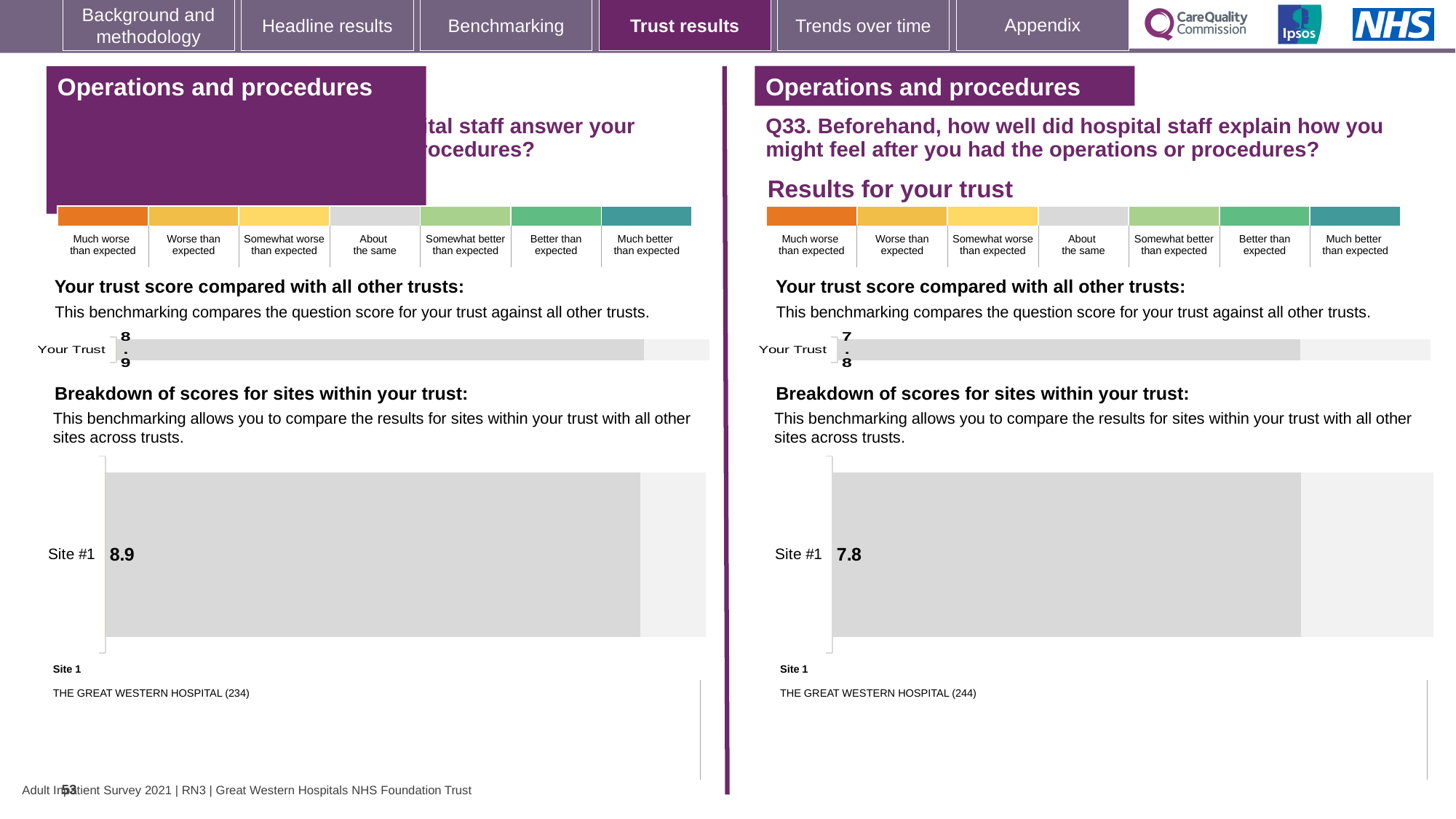
On the right panel (Q33), what is the score shown for Your Trust in the 'Your trust score compared with all other trusts' chart? 7.8 How many sites are shown in the 'Breakdown of scores for sites within your trust' chart on the right panel (Q33)? 1 Which is larger: the Your Trust score on the left panel or the Your Trust score on the right panel (Q33)? Left panel On the left panel, what is the score shown for Your Trust in the 'Your trust score compared with all other trusts' chart? 8.9 What is the difference between the Site #1 score on the left panel and the Site #1 score on the right panel (Q33)? 1.1 On the right panel (Q33), what score is shown for Site #1 in the 'Breakdown of scores for sites within your trust' chart? 7.8 On the left panel, what score is shown for Site #1 in the 'Breakdown of scores for sites within your trust' chart? 8.9 On the right panel (Q33), which site is listed as Site 1 below the breakdown chart? THE GREAT WESTERN HOSPITAL (244) Is the Your Trust score on the right panel (Q33) equal to the Site #1 score on the same panel? Yes What kind of chart is used to show the Site #1 score on the left panel? Bar chart On the left panel, which site is listed as Site 1 below the breakdown chart? THE GREAT WESTERN HOSPITAL (234)